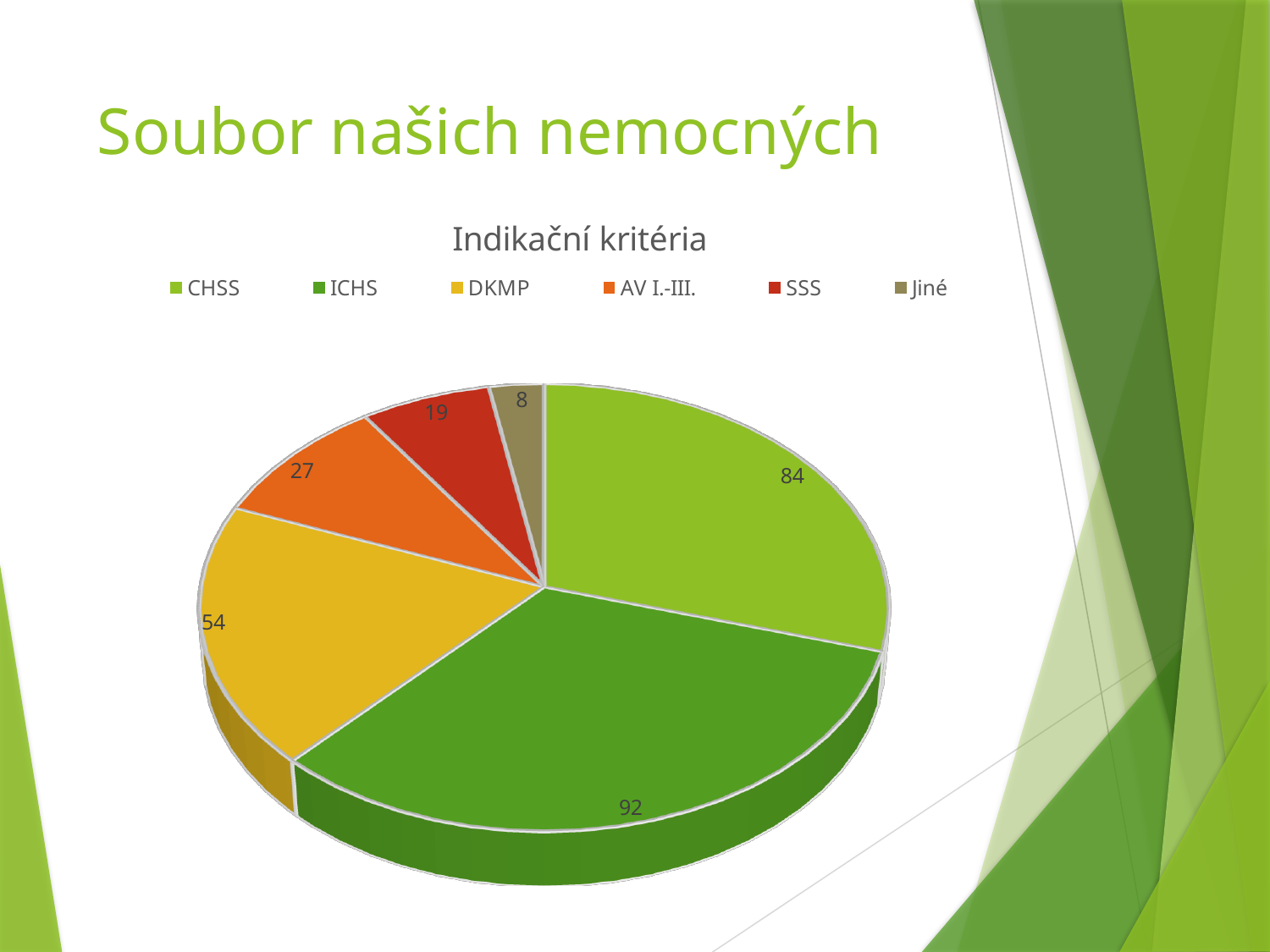
What kind of chart is shown on the slide? pie chart What is the title of the chart? Indikační kritéria What is the value for SSS? 19 How many series does the legend list? 6 What is the value for CHSS? 84 What is the value for ICHS? 92 Which category has the smallest slice? Jiné What is the difference between the values for ICHS and CHSS? 8 What is the value for DKMP? 54 Which category has the largest slice? ICHS What is the value for AV I.-III.? 27 Which is larger, the value for DKMP or the value for AV I.-III.? DKMP